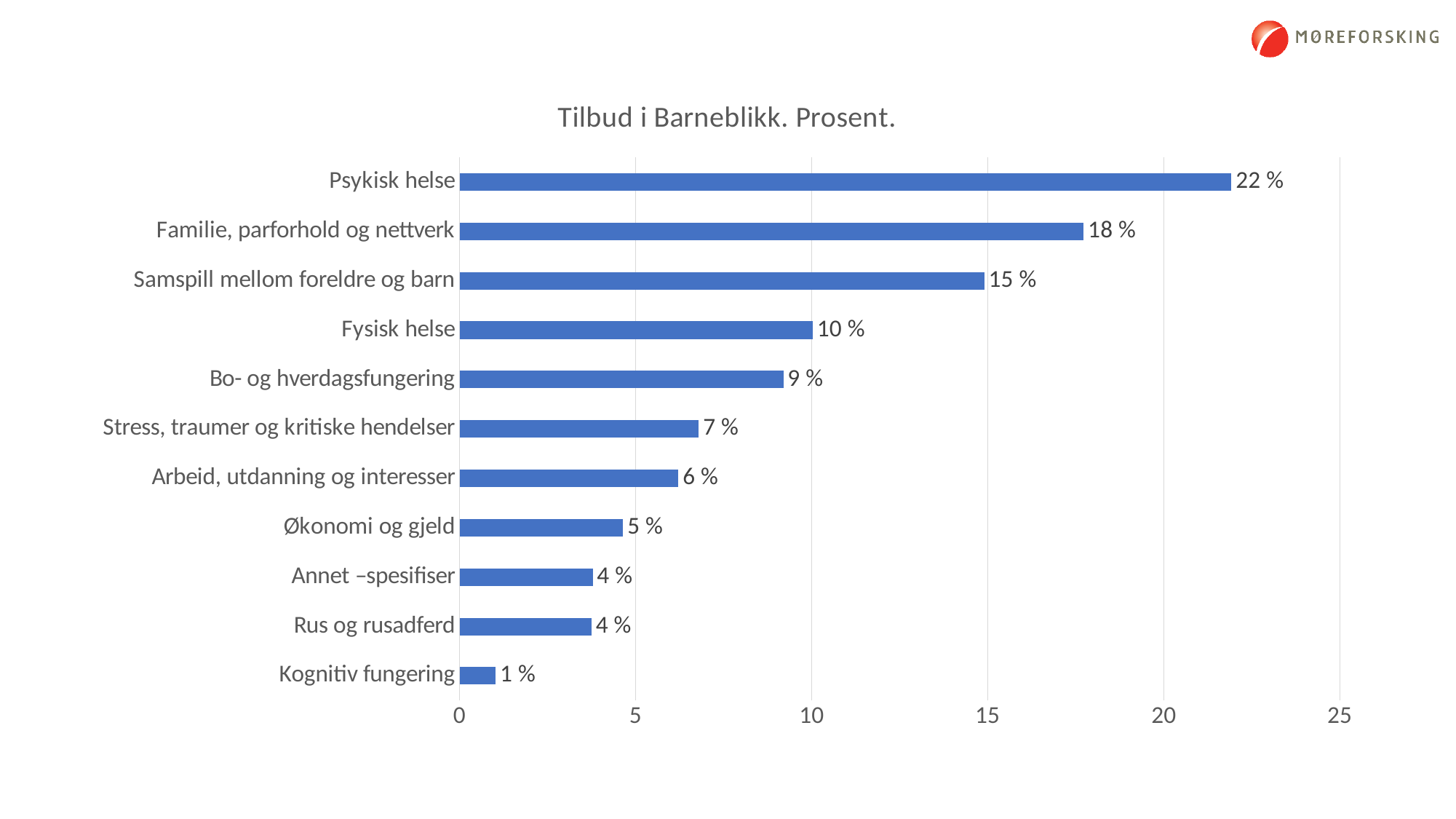
Which is larger, Bo- og hverdagsfungering or Stress, traumer og kritiske hendelser? Bo- og hverdagsfungering What is the value for Fysisk helse? 10 % What is the value for Psykisk helse? 22 % Is the value for Familie, parforhold og nettverk greater or less than 15? greater What is the difference between Psykisk helse and Familie, parforhold og nettverk? 4 % What is the value for Økonomi og gjeld? 5 % Which category has the highest value? Psykisk helse What is the title of the chart? Tilbud i Barneblikk. Prosent. How many categories are shown in the chart? 11 What is the difference between Samspill mellom foreldre og barn and Fysisk helse? 5 % What kind of chart is shown on the slide? Bar chart Which category has the lowest value? Kognitiv fungering